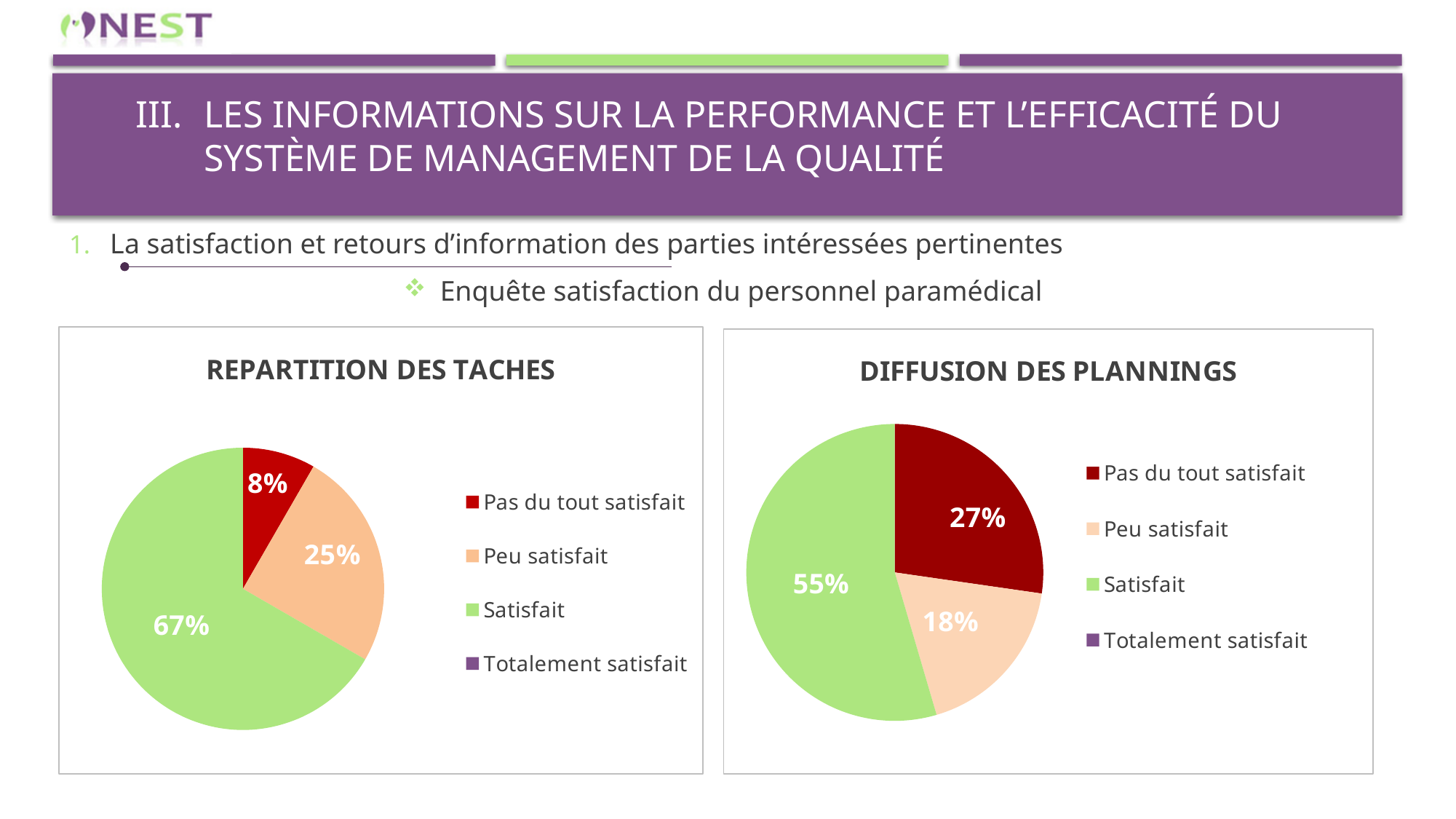
In the 'DIFFUSION DES PLANNINGS' chart, what percentage is shown for 'Peu satisfait'? 18% In the 'REPARTITION DES TACHES' chart, what percentage is shown for 'Satisfait'? 67% What type of chart is 'DIFFUSION DES PLANNINGS'? Pie chart In the 'DIFFUSION DES PLANNINGS' chart, what colour is the 'Satisfait' slice? Green In the 'REPARTITION DES TACHES' chart, what percentage is shown for 'Pas du tout satisfait'? 8% In the 'REPARTITION DES TACHES' chart, what is the difference between the 'Peu satisfait' and 'Pas du tout satisfait' percentages? 17% Which chart has the larger 'Pas du tout satisfait' share, 'REPARTITION DES TACHES' or 'DIFFUSION DES PLANNINGS'? DIFFUSION DES PLANNINGS How many entries does the legend of the 'REPARTITION DES TACHES' chart list? 4 In the 'REPARTITION DES TACHES' chart, which category has the largest slice? Satisfait In the 'DIFFUSION DES PLANNINGS' chart, what percentage is shown for 'Pas du tout satisfait'? 27% In the 'DIFFUSION DES PLANNINGS' chart, which labelled category has the smallest slice? Peu satisfait In the 'DIFFUSION DES PLANNINGS' chart, what is the difference between the 'Satisfait' and 'Pas du tout satisfait' percentages? 28%